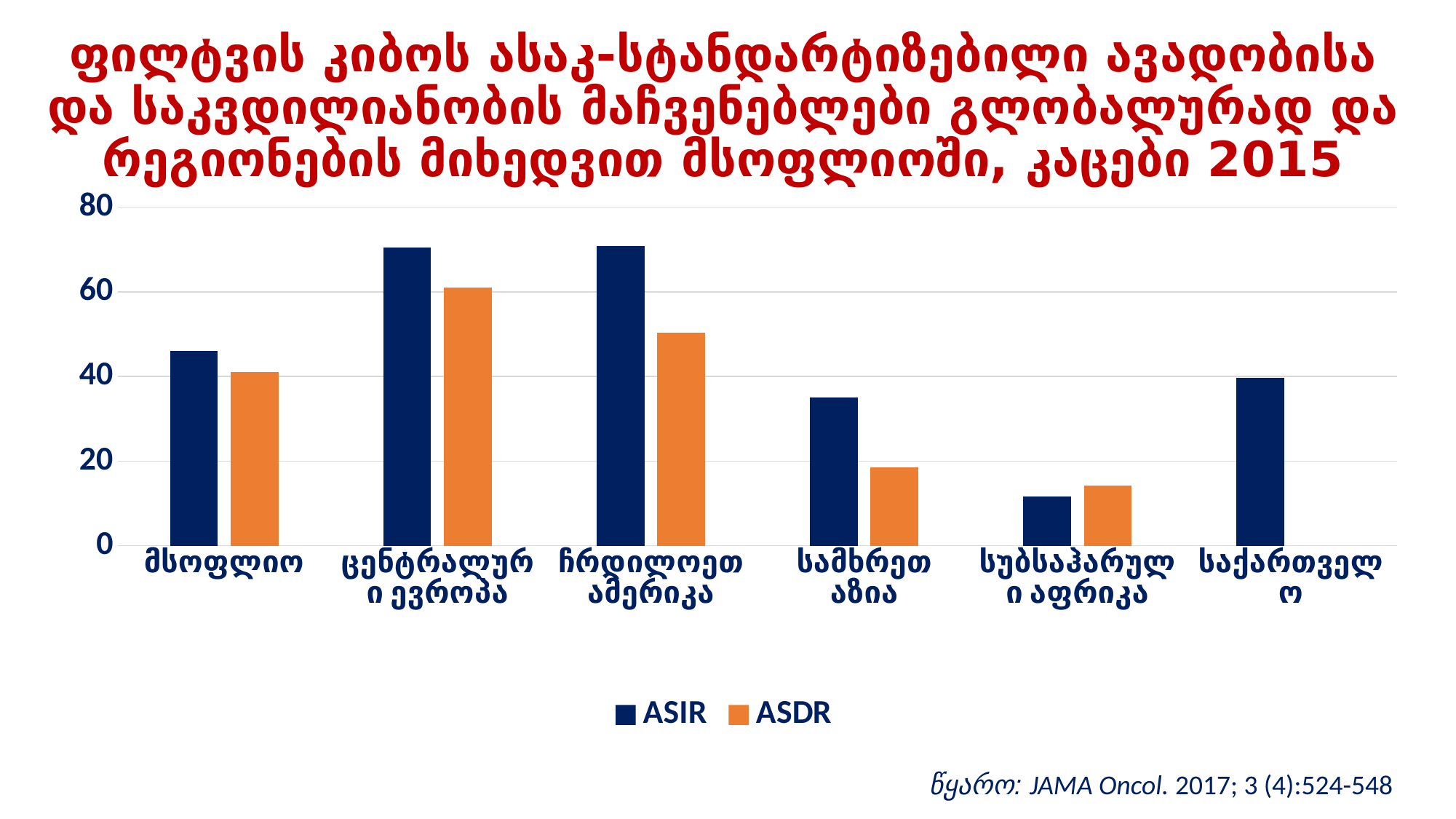
What kind of chart is shown on the slide? bar chart Is the ASIR value for მსოფლიო greater or less than 40? greater Which category has the highest ASDR value? ცენტრალური ევროპა How many categories are shown on the x axis? 6 What are the two series names listed in the legend? ASIR and ASDR Is the ASDR value for სამხრეთ აზია greater or less than 20? less For ჩრდილოეთ ამერიკა, which is larger, the ASIR value or the ASDR value? ASIR How many series does the legend list? 2 Is the ASIR value for საქართველო greater or less than 20? greater For სუბსაჰარული აფრიკა, which is larger, the ASIR value or the ASDR value? ASDR Which category has the lowest ASIR value? სუბსაჰარული აფრიკა